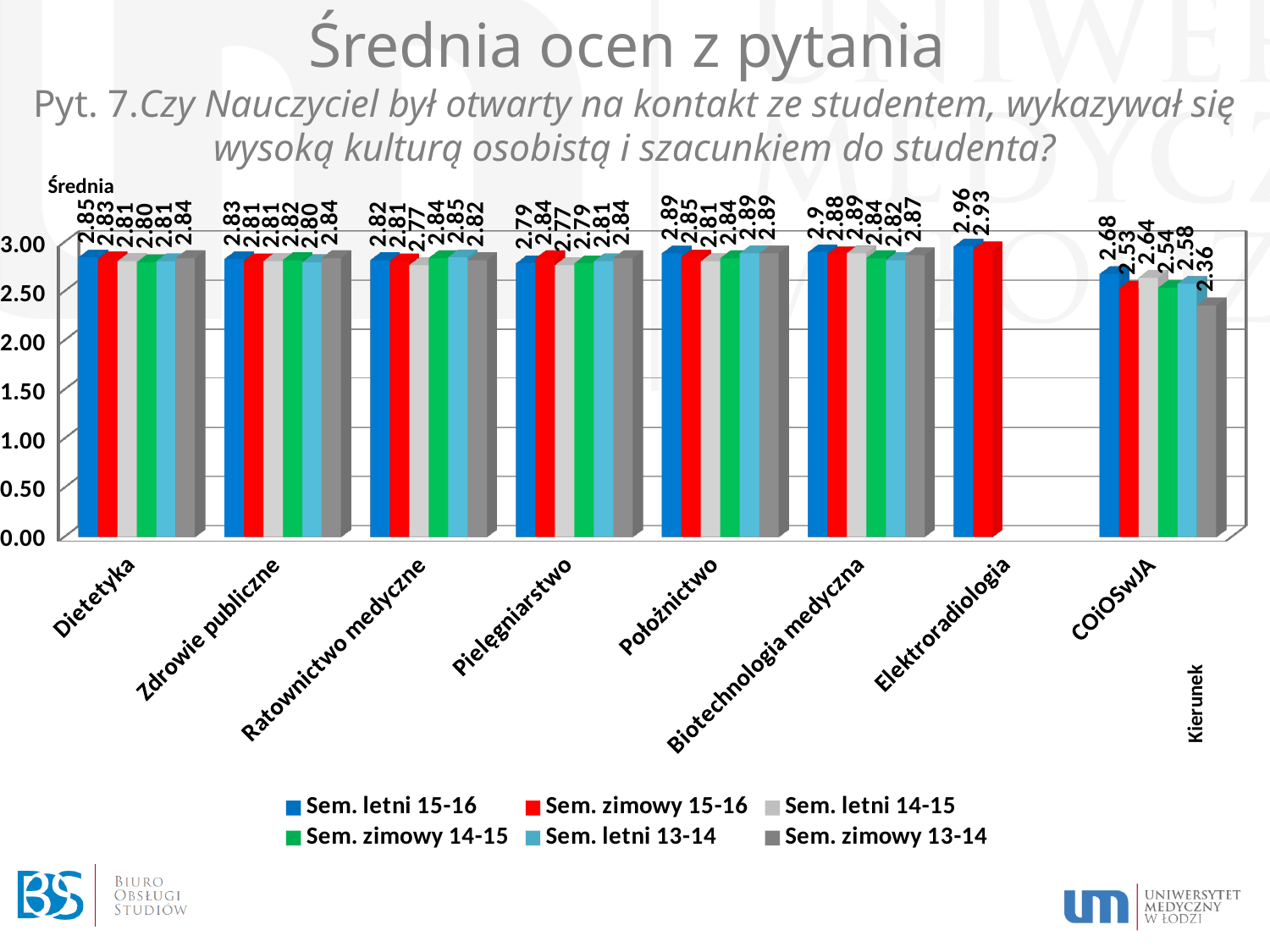
How many categories (kierunki) are shown on the x axis? 8 What kind of chart is shown on the slide? Bar chart Which category has the lowest value in the Sem. zimowy 13-14 series? COiOSwJA How many series does the legend list? 6 What is the value for COiOSwJA in the Sem. zimowy 13-14 series? 2.36 What is the value for Biotechnologia medyczna in the Sem. letni 15-16 series? 2.9 What is the value for Dietetyka in the Sem. letni 15-16 series? 2.85 Which series is shown in red in the legend? Sem. zimowy 15-16 Which category has the highest value in the Sem. letni 15-16 series? Elektroradiologia What is the value for Elektroradiologia in the Sem. zimowy 15-16 series? 2.93 Which is larger for Pielęgniarstwo: the Sem. zimowy 15-16 value or the Sem. letni 14-15 value? Sem. zimowy 15-16 What is the difference between the Sem. letni 15-16 value for Elektroradiologia and the Sem. letni 15-16 value for COiOSwJA? 0.28